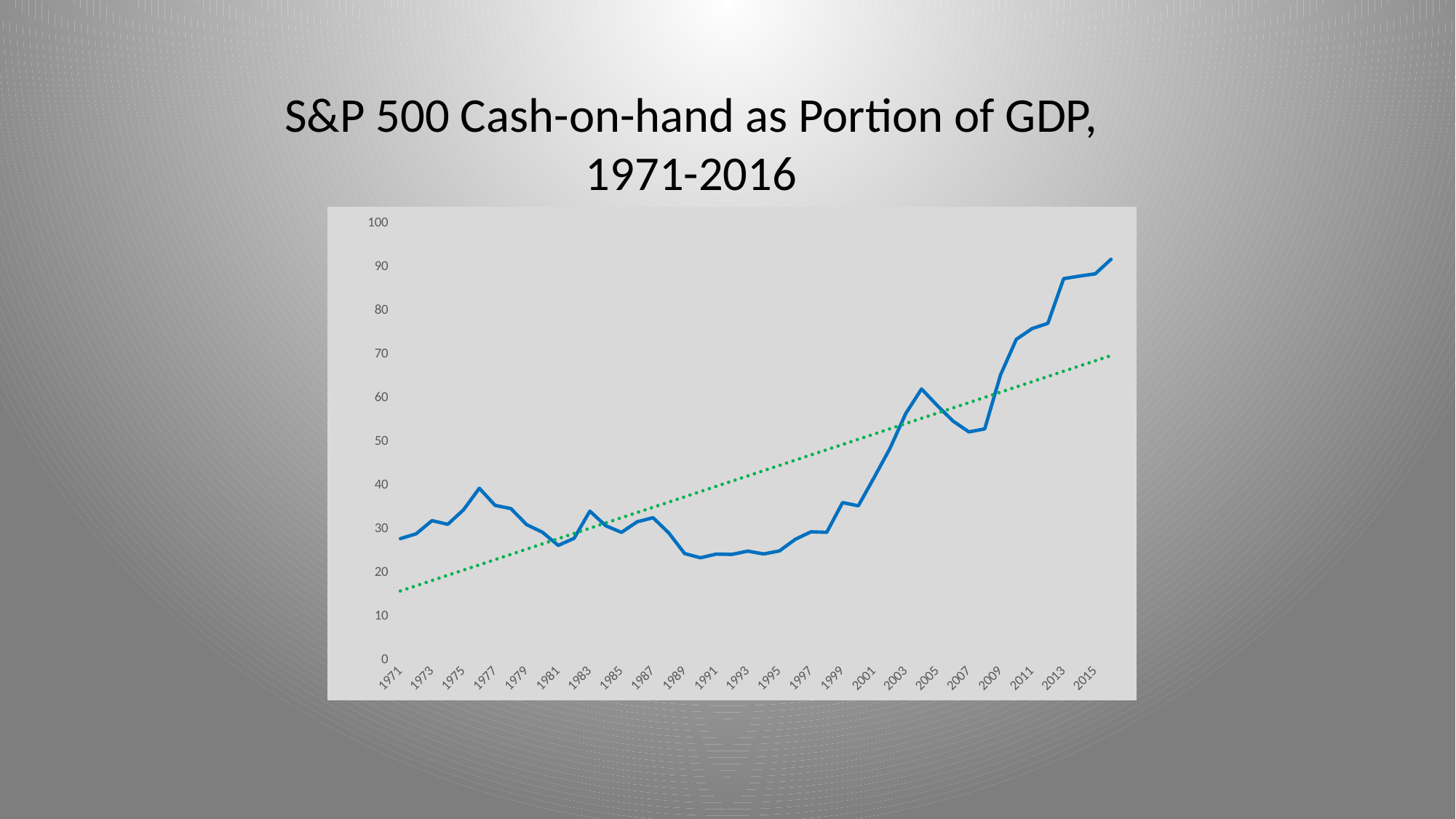
How many year labels are shown on the x axis? 23 Which year has the highest value on the chart? 2016 Is the value for 2008 greater or less than 60? less Is the value for 2013 greater or less than 80? greater What is the title of the chart? S&P 500 Cash-on-hand as Portion of GDP, 1971-2016 What colour is the solid data line in the chart? blue Is the value for 1971 greater or less than 30? less Does the value generally rise or fall from 2009 to 2016? rise What kind of chart is shown on the slide? line chart Which is larger, the value for 1977 or the value for 1991? 1977